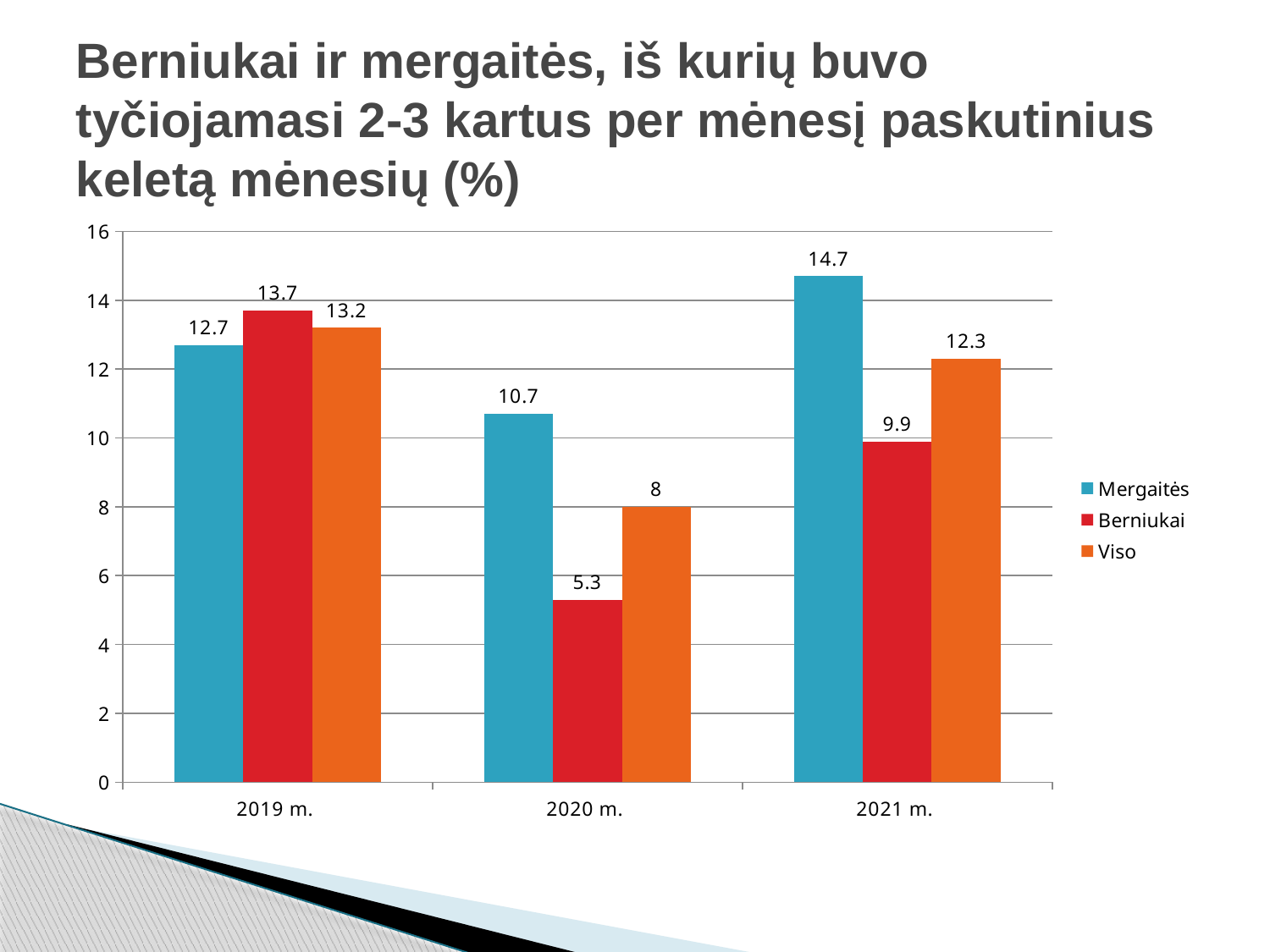
What is the value for Berniukai in 2020 m.? 5.3 What kind of chart is shown on the slide? bar chart What is the difference between the Mergaitės and Berniukai values in 2020 m.? 5.4 How many years are shown on the x axis? 3 What is the value for Viso in 2019 m.? 13.2 Which is larger in 2019 m., Mergaitės or Berniukai? Berniukai In which year is the Mergaitės value highest? 2021 m. Is the value for Viso in 2020 m. greater or less than 10? less What is the value for Mergaitės in 2021 m.? 14.7 In which year is the Berniukai value lowest? 2020 m. How many series does the legend list? 3 Which colour represents the Viso series? orange